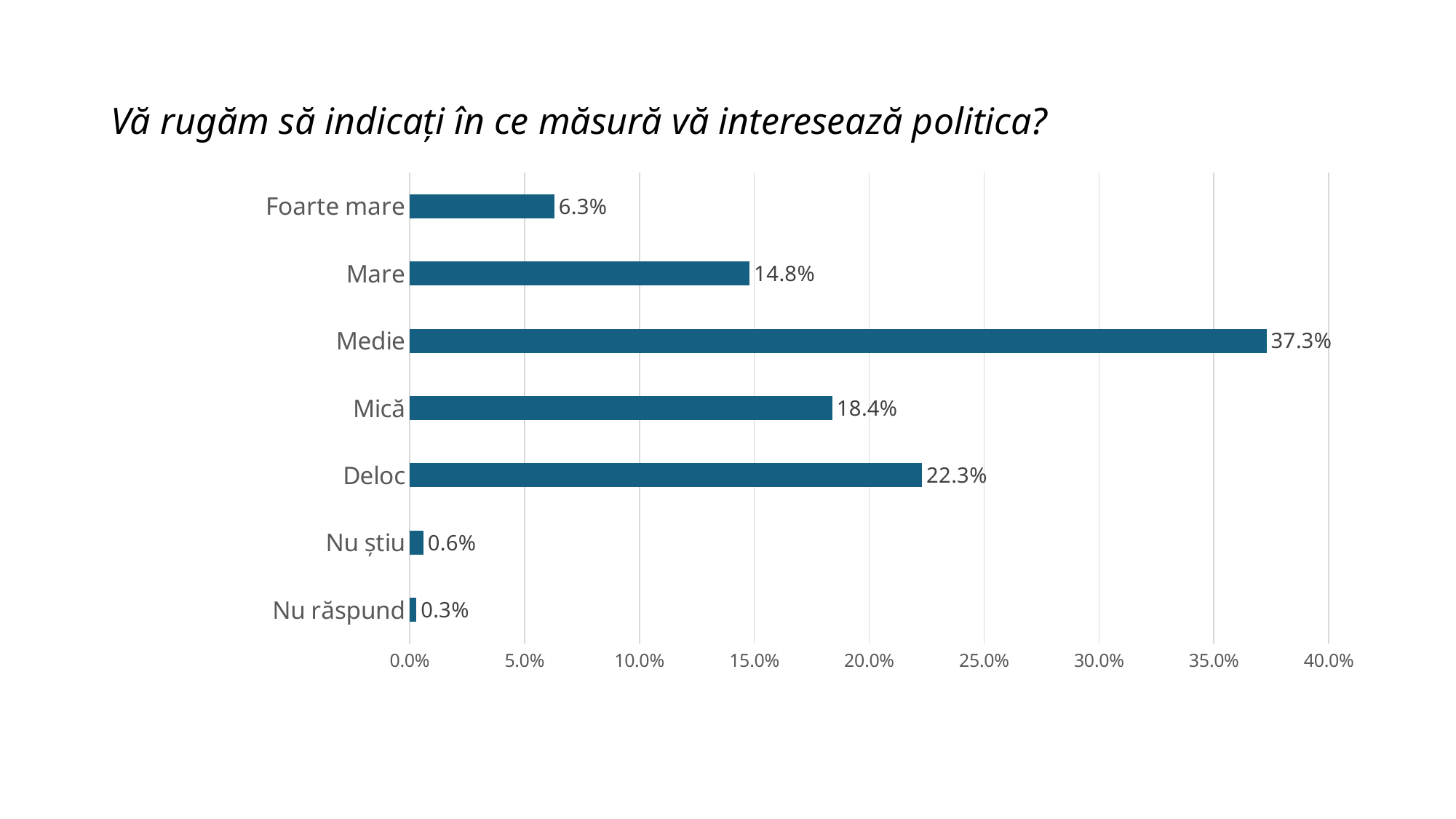
Which category has the lowest value? Nu răspund What kind of chart is shown on the slide? bar chart What is the title of the chart? Vă rugăm să indicați în ce măsură vă interesează politica? What is the value for Deloc? 22.3% How many categories are shown in the chart? 7 What is the value for Medie? 37.3% Which category has the highest value? Medie What is the value for Foarte mare? 6.3% What is the difference between the values for Medie and Foarte mare? 31.0% Is the value for Medie greater or less than 35.0%? greater What is the difference between the values for Deloc and Mică? 3.9% Which is larger, the value for Mare or the value for Mică? Mică